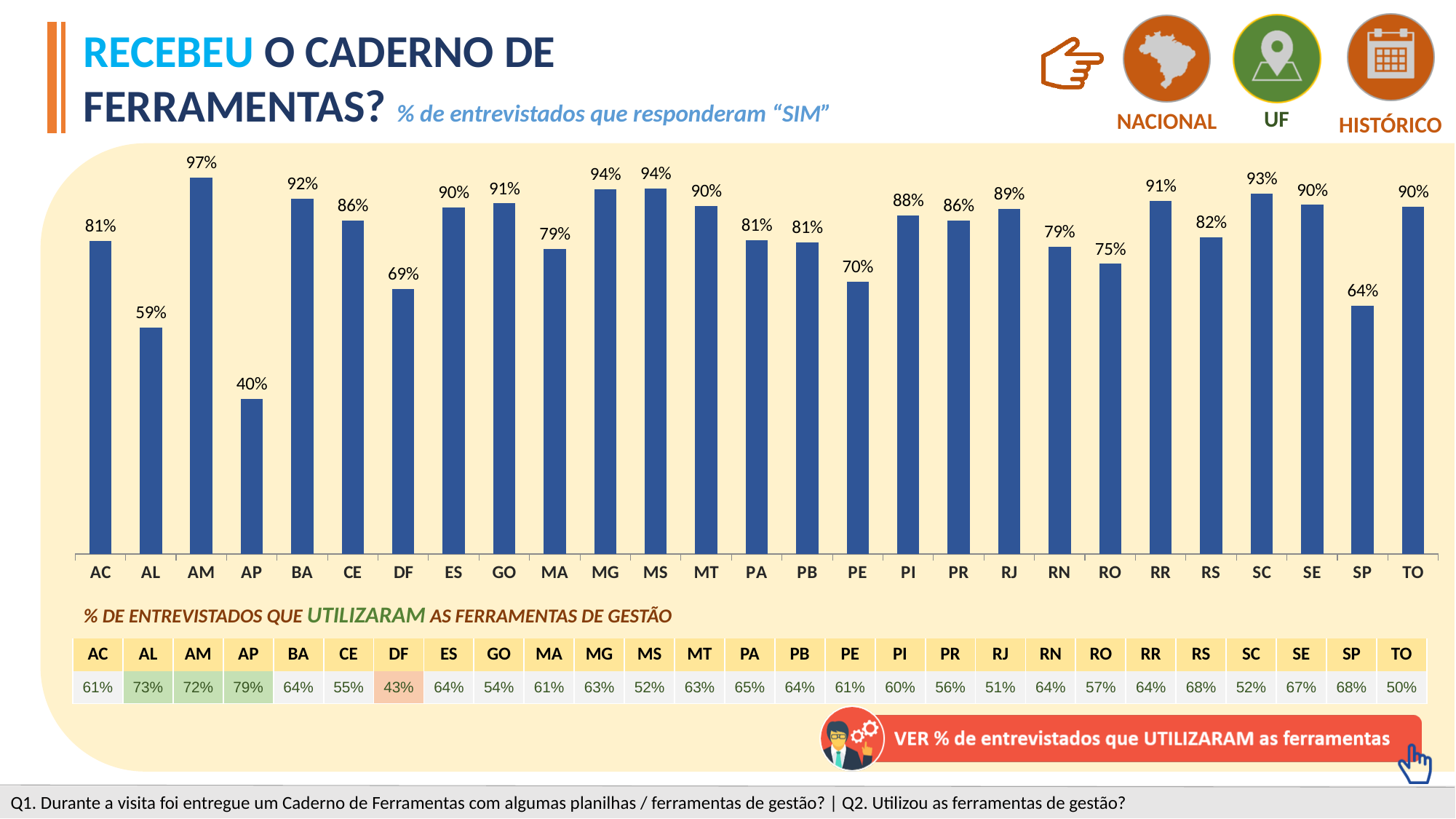
Which state has the highest value in the bar chart? AM How many states are shown in the bar chart? 27 What is the difference between the values for BA and AL in the bar chart? 33 percentage points What is the value for DF in the bar chart? 69% Which has a larger value in the bar chart, DF or SP? DF What is the difference between the values for AM and AP in the bar chart? 57 percentage points What is the value for SP in the bar chart? 64% Which state has the lowest value in the bar chart? AP Which has a larger value in the bar chart, SC or RS? SC What is the value for AM in the bar chart? 97% What kind of chart is shown on the slide? Bar chart What is the value for AP in the bar chart? 40%